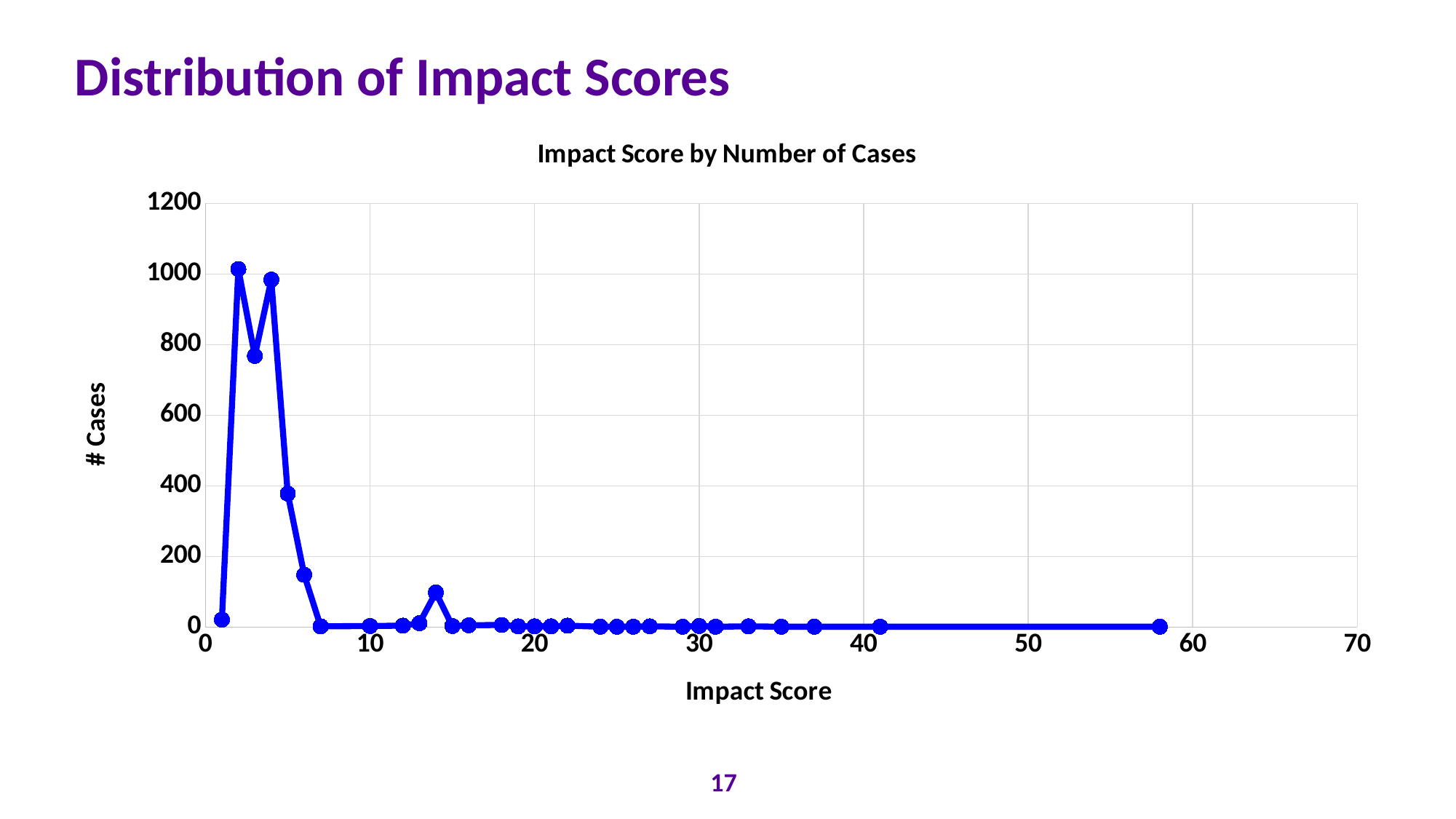
What is the label on the vertical axis of the chart? # Cases Which has more cases, impact score 4 or impact score 5? impact score 4 Is the number of cases at impact score 5 greater or less than 200? greater What is the title of the chart? Impact Score by Number of Cases Do the number of cases rise or fall as the impact score increases from 4 to 7? fall Is the number of cases at impact score 6 greater or less than 200? less Is the number of cases at impact score 1 greater or less than 200? less Which has more cases, impact score 2 or impact score 3? impact score 2 What kind of chart is shown on the slide? line chart